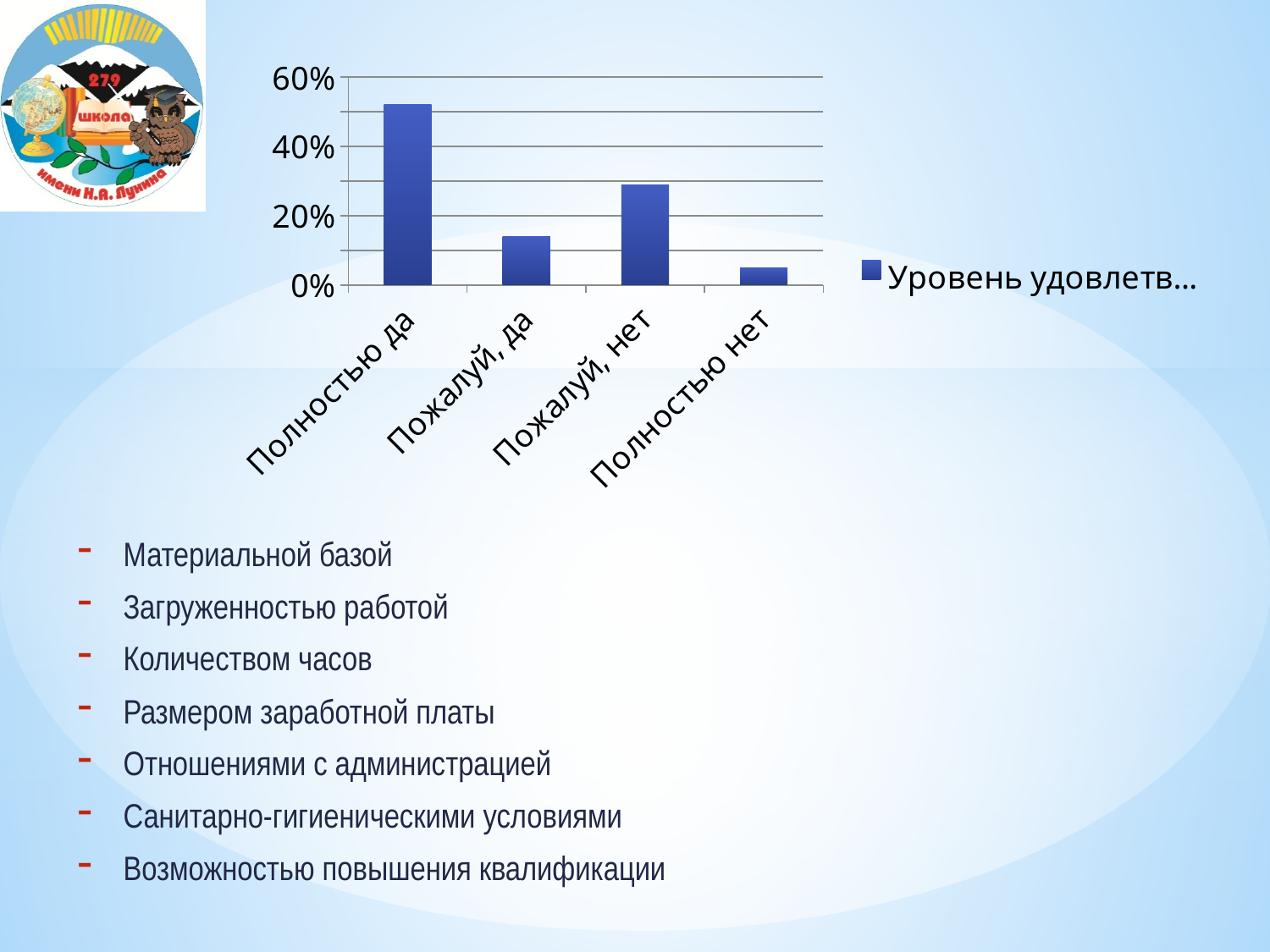
What is the highest value shown on the chart's vertical axis? 60% Is the value for "Пожалуй, да" greater or less than 20%? less Which category has the highest value in the chart? Полностью да Which is larger, the value for "Пожалуй, да" or the value for "Пожалуй, нет"? Пожалуй, нет Is the value for "Пожалуй, нет" greater or less than 20%? greater How many series does the chart's legend list? 1 Which category has the lowest value in the chart? Полностью нет How many categories are shown on the x axis of the chart? 4 Which is larger, the value for "Полностью да" or the value for "Пожалуй, нет"? Полностью да Is the value for "Полностью да" greater or less than 40%? greater What kind of chart is shown on the slide? bar chart